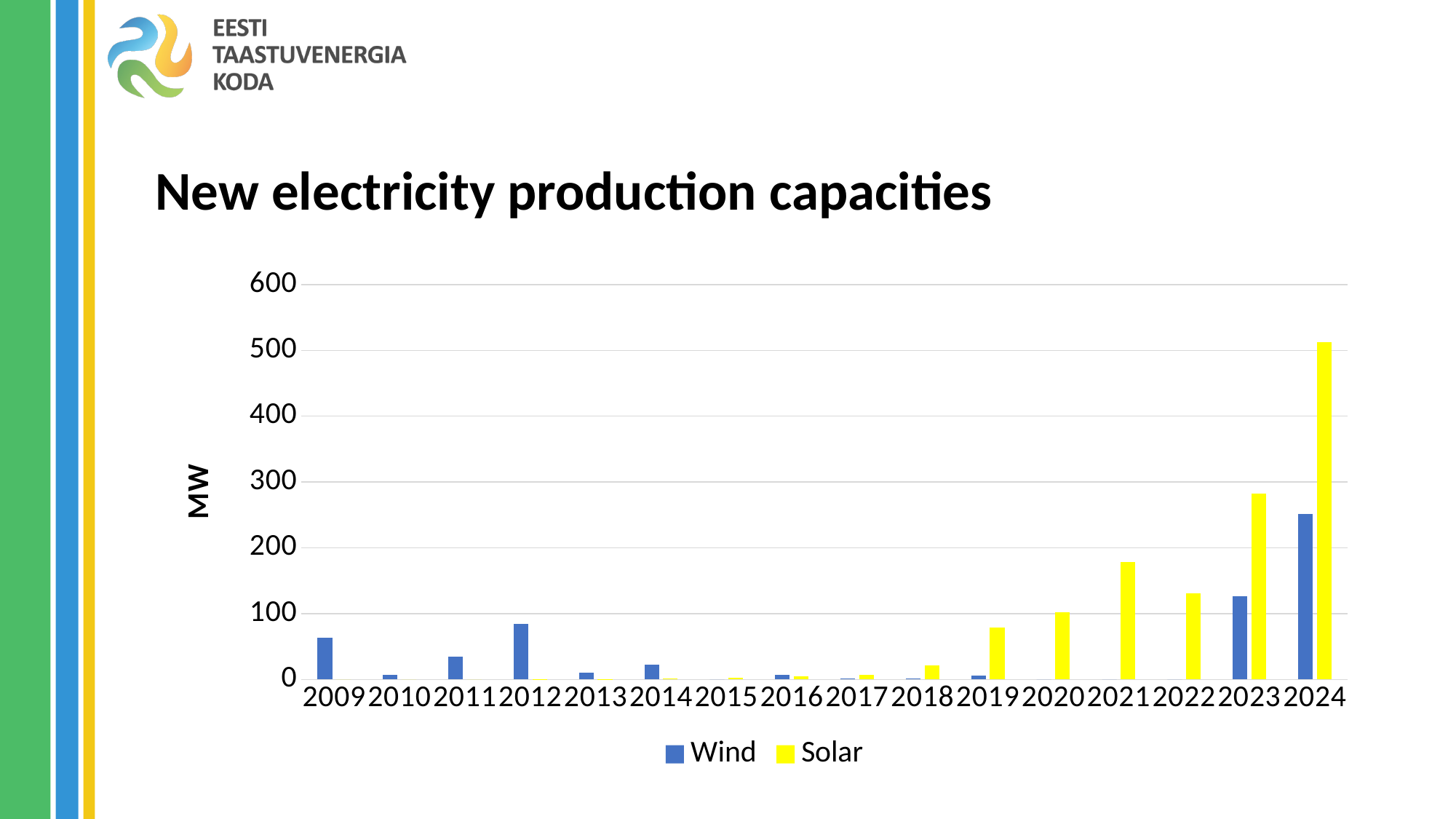
What is the label on the vertical axis? MW Is the Wind value for 2024 greater or less than 200? greater In which year is the Solar value highest? 2024 Which is larger in 2023, the Wind value or the Solar value? Solar Is the Solar value for 2023 greater or less than 300? less Do the Solar values rise or fall from 2017 to 2021? rise How many series does the legend list? 2 In which year is the Wind value highest? 2024 Is the Solar value for 2024 greater or less than 500? greater How many years are shown on the x axis? 16 What kind of chart is shown on the slide? bar chart